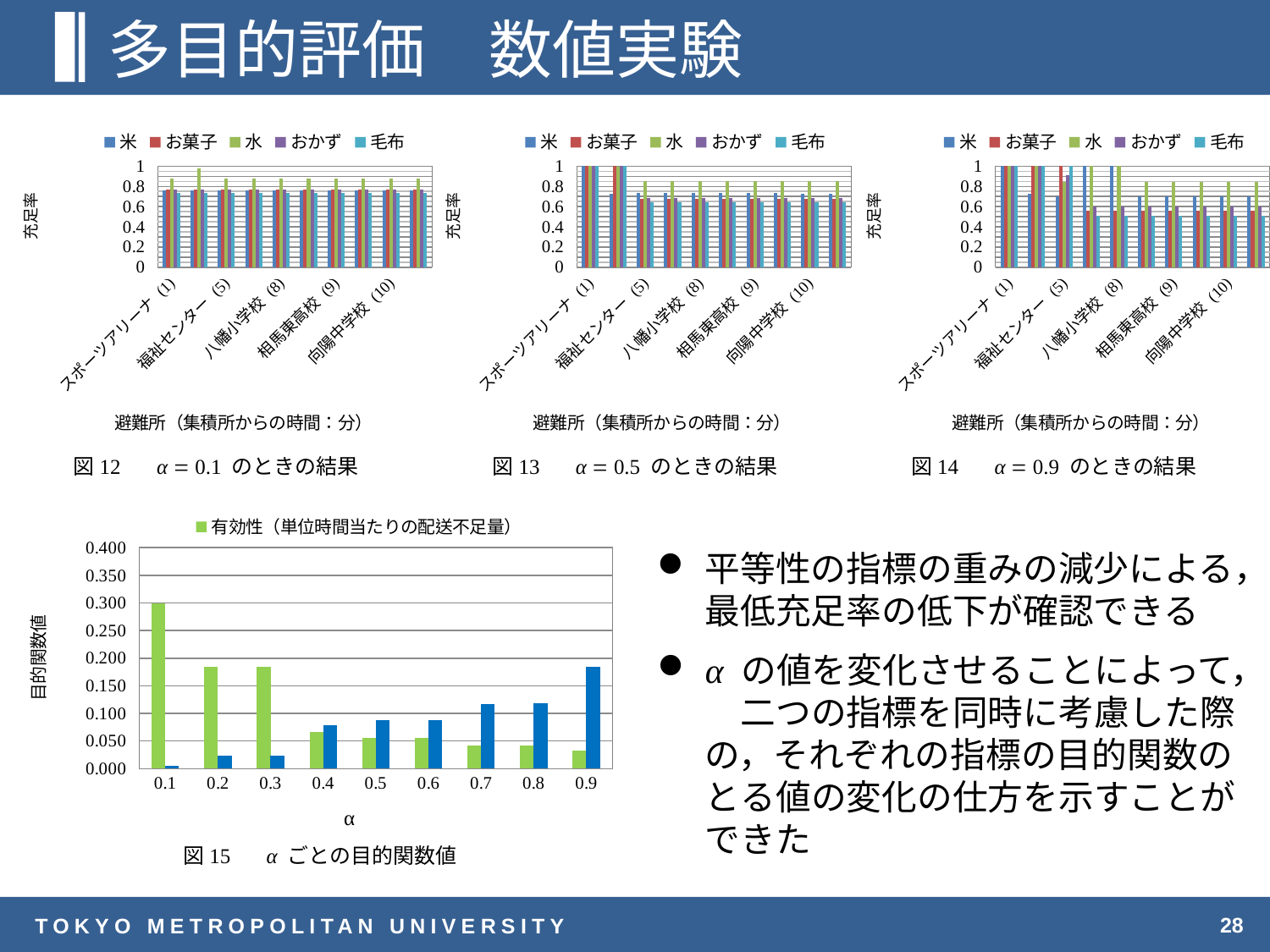
In 図 15 (α ごとの目的関数値), at α = 0.7, which bar is larger, the green one or the blue one? the blue one What kind of chart is 図 12 (α = 0.1 のときの結果)? bar chart What kind of chart is 図 15 (α ごとの目的関数値)? bar chart In 図 15 (α ごとの目的関数値), is the green bar at α = 0.1 greater or less than 0.250? greater How many series does the legend of 図 12 (α = 0.1 のときの結果) list? 5 In 図 12 (α = 0.1 のときの結果), is the 水 value for スポーツアリーナ (1) greater or less than 0.6? greater In 図 15 (α ごとの目的関数値), do the green bars generally rise or fall as α increases from 0.1 to 0.9? fall In 図 15 (α ごとの目的関数値), at which α value is the green bar highest? 0.1 In 図 15 (α ごとの目的関数値), what is the label on the y axis? 目的関数値 In 図 15 (α ごとの目的関数値), at which α value is the blue bar highest? 0.9 In 図 15 (α ごとの目的関数値), is the blue bar at α = 0.9 greater or less than 0.150? greater In 図 15 (α ごとの目的関数値), how many α values are shown on the x axis? 9